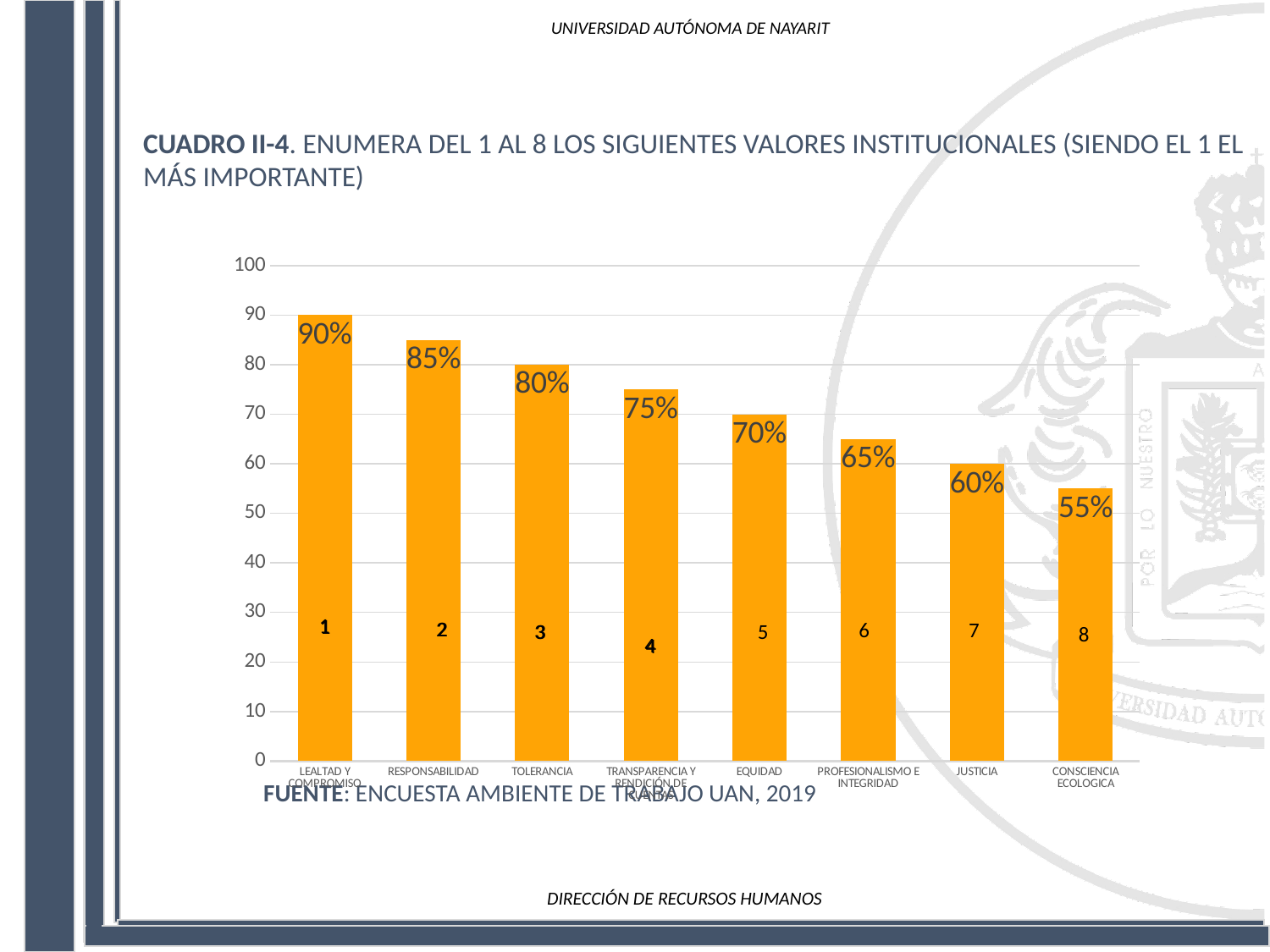
What is the value shown for CONSCIENCIA ECOLOGICA? 55% What is the value shown for JUSTICIA? 60% Which category has the highest value? LEALTAD Y COMPROMISO Which category has the lowest value? CONSCIENCIA ECOLOGICA What is the value shown for EQUIDAD? 70% What is the value shown for RESPONSABILIDAD? 85% Do the values rise or fall from left to right along the x axis? fall Which is larger, the value for RESPONSABILIDAD or the value for JUSTICIA? RESPONSABILIDAD What is the difference between the values for TOLERANCIA and PROFESIONALISMO E INTEGRIDAD? 15% How many categories are shown in the chart? 8 What kind of chart is shown on the slide? bar chart Is the value for EQUIDAD greater or less than 60? greater